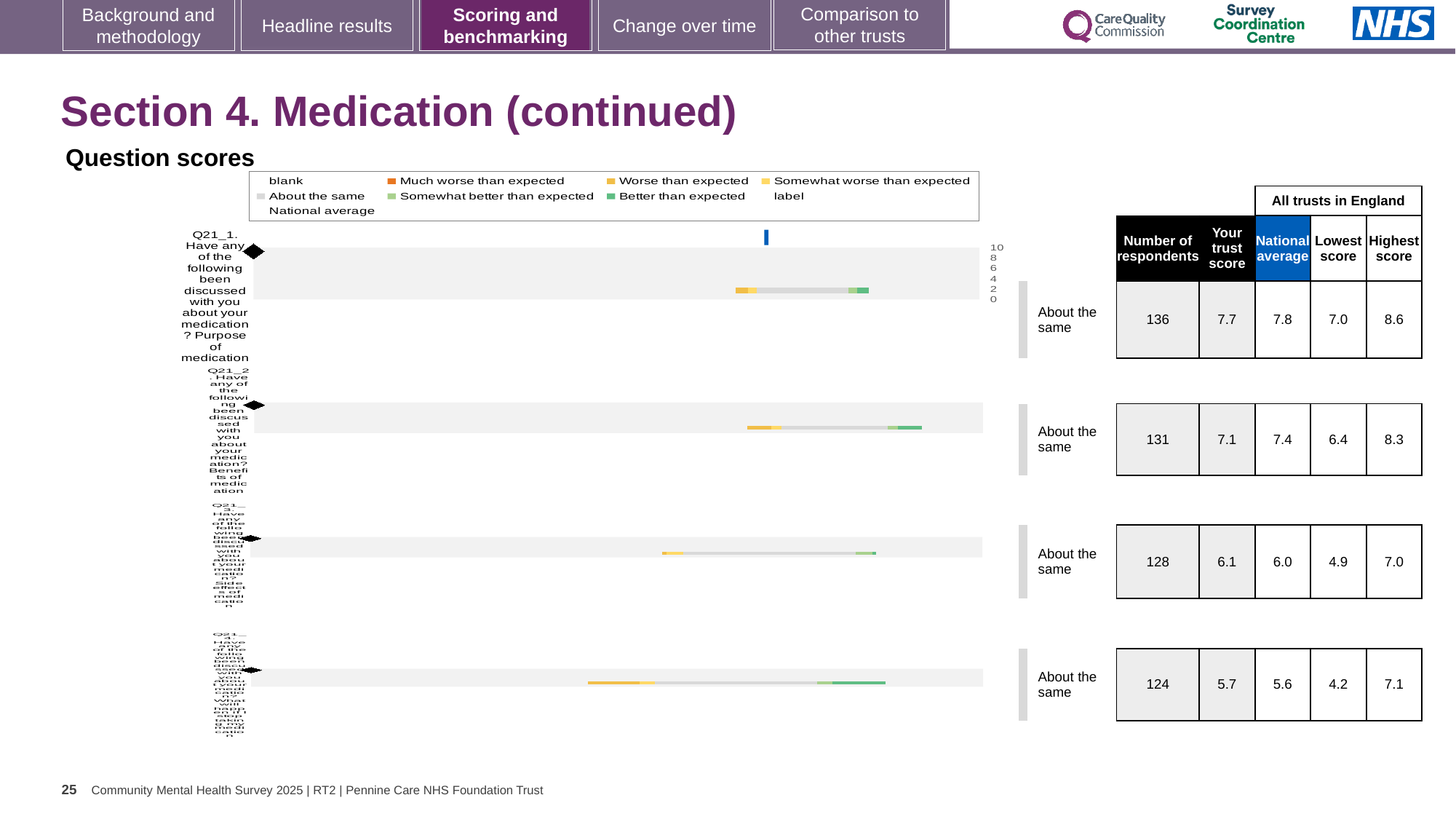
Do the 'Your trust score' values rise or fall going from Q21_1 down to Q21_4? fall What is the difference between the highest score (8.6) and the lowest score (7.0) for Q21_1? 1.6 How many questions (bars) are plotted in the Question scores chart? 4 Which question has the highest 'Your trust score' on this slide? Q21_1 (Purpose of medication) What is the highest score across all trusts in England for Q21_4 (What might happen if I stop taking medication)? 7.1 Which question has the lowest 'Your trust score' on this slide? Q21_4 (What might happen if I stop taking medication) For Q21_2, which is larger: the trust score or the national average? National average How many respondents answered Q21_3 (Side effects of medication)? 128 What kind of chart is used to show the question scores on this slide? bar chart What benchmark category is shown for all four questions on this slide? About the same What is the 'Your trust score' for Q21_1 (Purpose of medication) in the table beside the chart? 7.7 What is the national average for Q21_2 (Benefits of medication)? 7.4